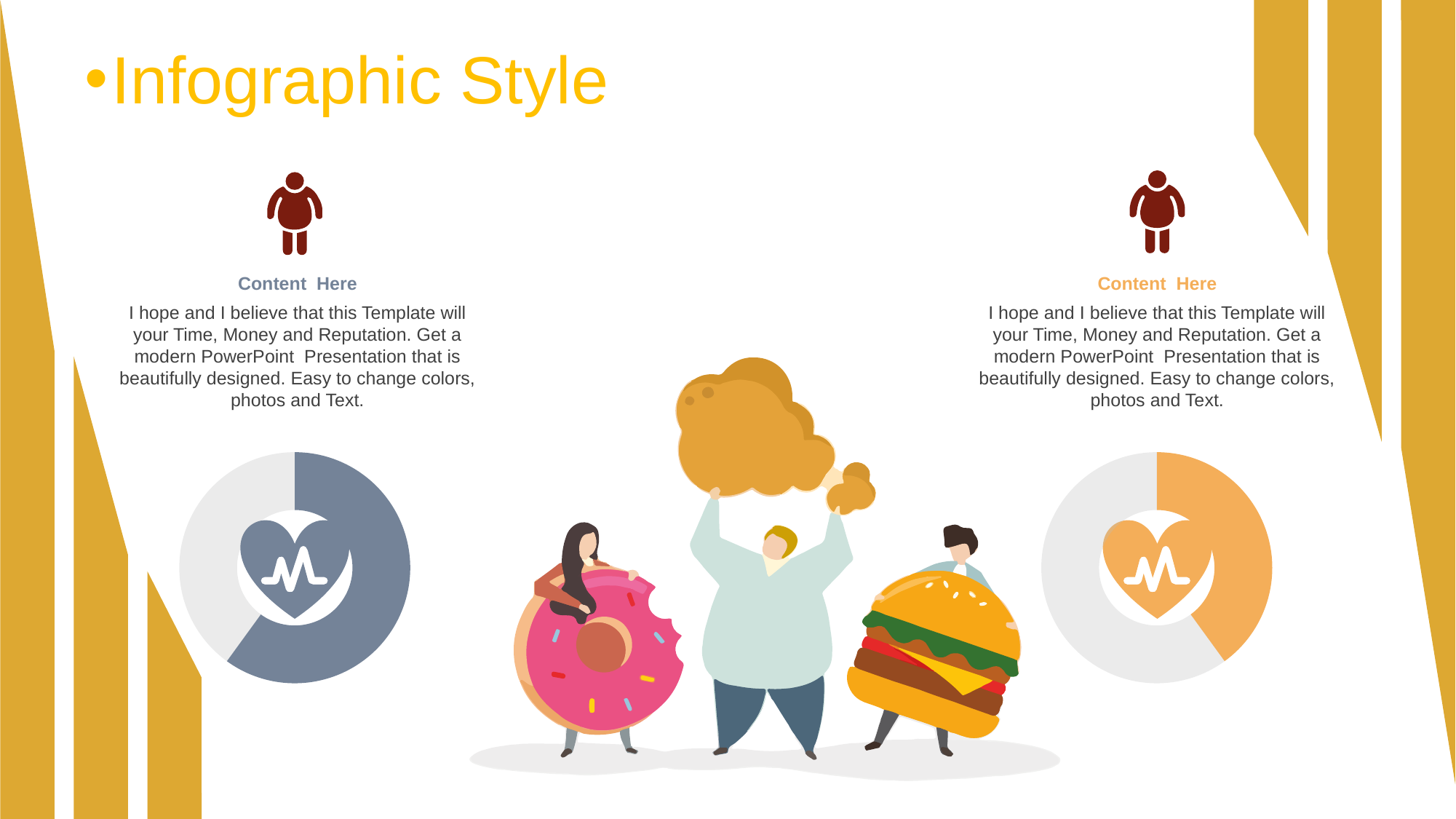
What colour is the coloured slice of the right doughnut chart? orange How many slices does the left doughnut chart have? 2 What icon is shown in the centre of each doughnut chart? a heart with a pulse line How many slices does the right doughnut chart have? 2 In the right doughnut chart, which slice is larger, the orange slice or the light gray slice? the light gray slice What kind of chart is shown on the right side of the slide? doughnut chart In the left doughnut chart, which slice is larger, the blue-gray slice or the light gray slice? the blue-gray slice What kind of chart is shown on the left side of the slide? doughnut chart How many doughnut charts are on the slide? 2